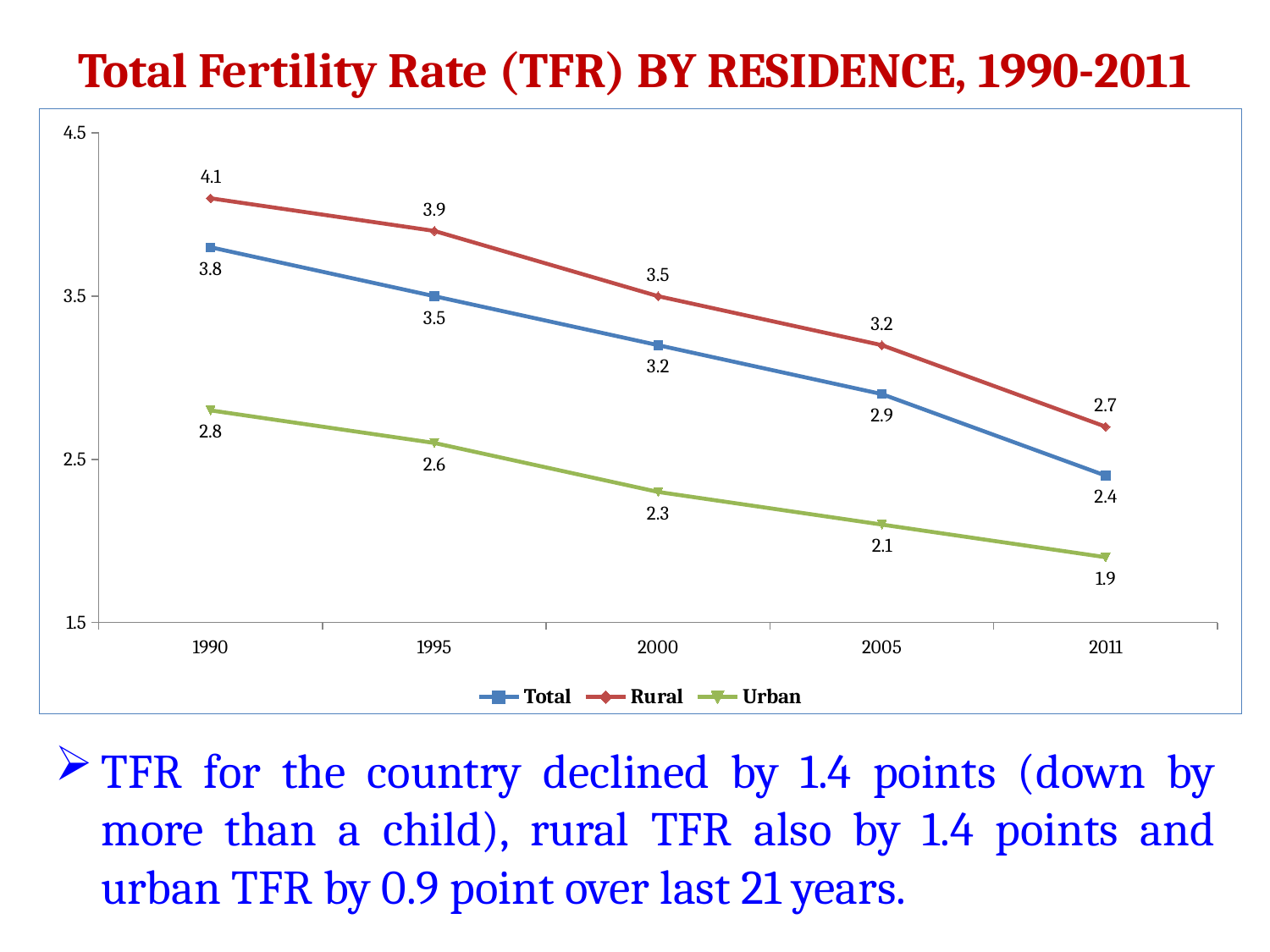
Does the Rural TFR rise or fall from 1990 to 2011? fall What is the Total TFR value in 2000? 3.2 What is the Urban TFR value in 2011? 1.9 In which year is the Rural TFR highest? 1990 How many years are shown on the x axis? 5 In which year is the Urban TFR lowest? 2011 Which is larger in 1995, the Total TFR or the Urban TFR? Total What kind of chart is shown on the slide? line chart How many series does the legend list? 3 What is the Rural TFR value in 1990? 4.1 What is the difference between the Rural and Urban TFR in 2005? 1.1 Is the Total TFR value in 2011 greater or less than 2.5? less